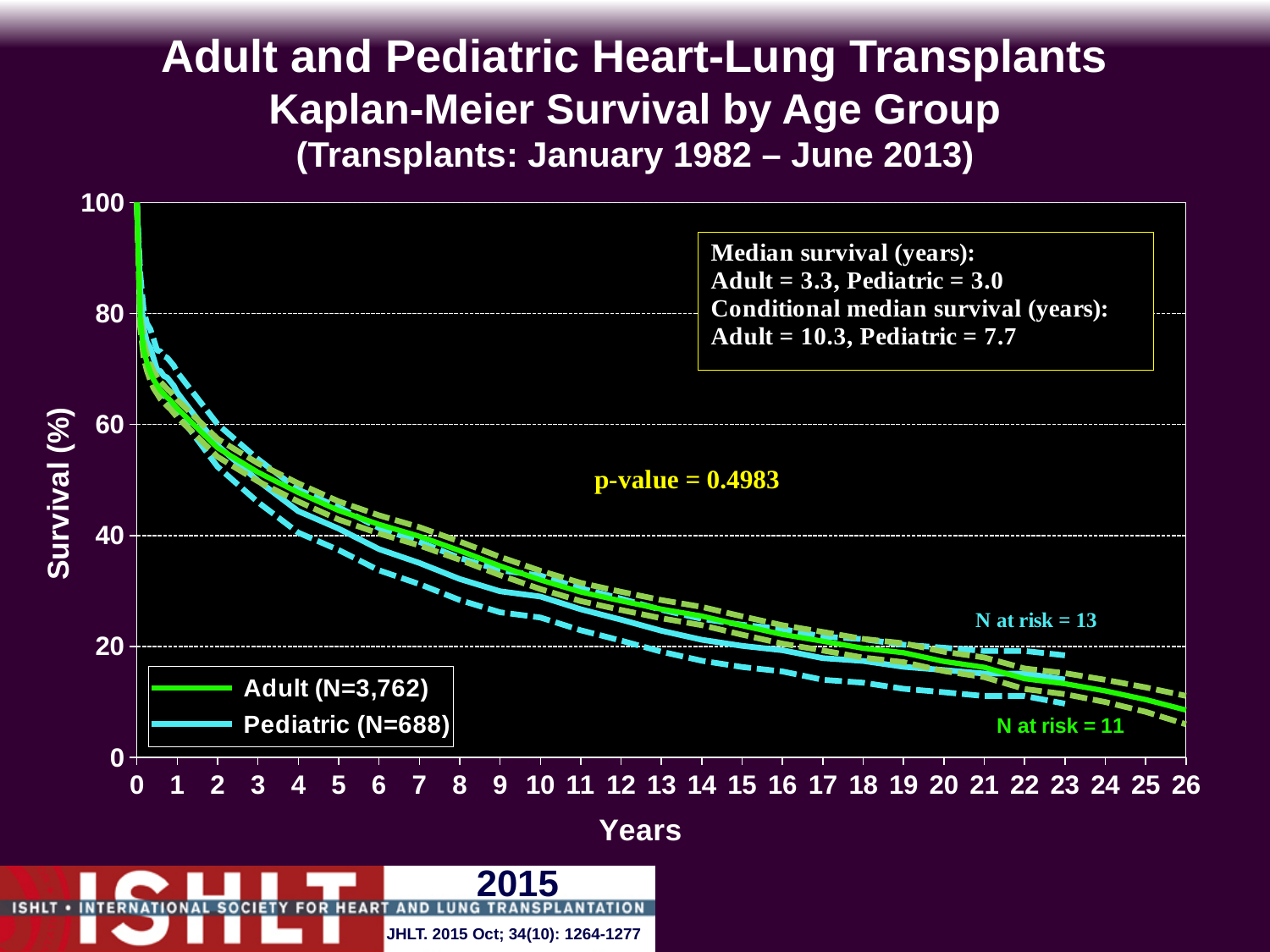
Which group has the higher conditional median survival, Adult or Pediatric? Adult What is the conditional median survival in years for the Pediatric group? 7.7 What is the sample size (N) for the Pediatric group shown in the legend? 688 Is the Adult survival value at year 10 greater or less than 40? less What is the median survival in years for the Adult group? 3.3 What is the sample size (N) for the Adult group shown in the legend? 3,762 What is the p-value shown on the chart? 0.4983 What kind of chart is shown on the slide? line chart What is the difference in conditional median survival (years) between the Adult and Pediatric groups? 2.6 How many series does the legend list? 2 Is the Pediatric survival value at year 20 greater or less than 20? less Do the survival curves rise or fall as years increase along the x axis? fall